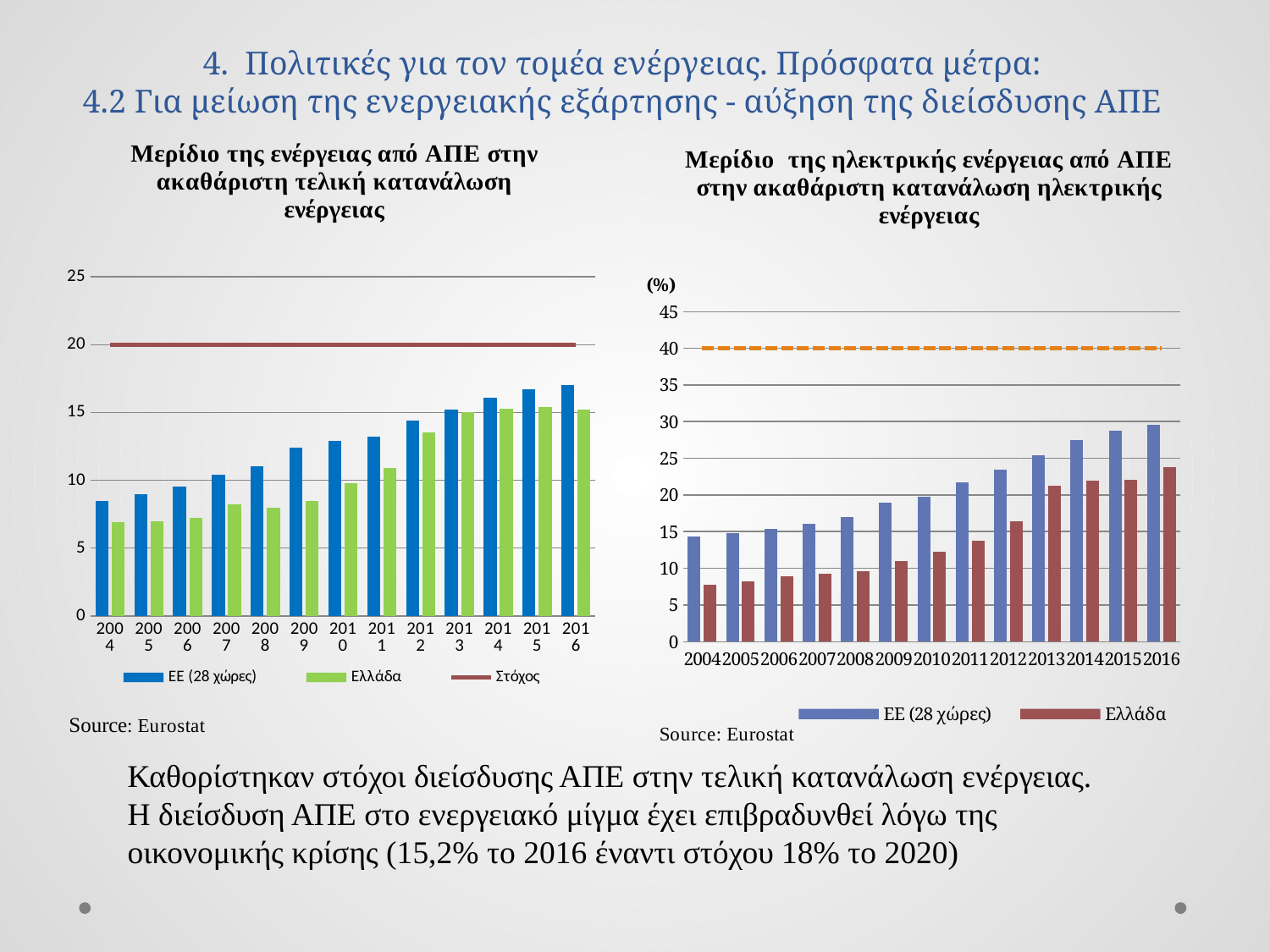
In the left chart, at what value does the Στόχος line sit? 20 What kind of chart is the left chart, 'Μερίδιο της ενέργειας από ΑΠΕ στην ακαθάριστη τελική κατανάλωση ενέργειας'? Combination bar and line chart (bars with a target line) How many years are shown on the x axis of the right chart? 13 How many series does the legend of the left chart list? 3 In the left chart, is the value for ΕΕ (28 χώρες) in 2016 greater or less than 15? greater In the right chart, is the value for ΕΕ (28 χώρες) in 2004 greater or less than 15? less In the left chart, which is larger in 2016: ΕΕ (28 χώρες) or Ελλάδα? ΕΕ (28 χώρες) In the left chart, is the value for Ελλάδα in 2004 greater or less than 10? less In the left chart, which year has the lowest value for ΕΕ (28 χώρες)? 2004 In the right chart, which year has the highest value for Ελλάδα? 2016 How many series does the legend of the right chart, 'Μερίδιο της ηλεκτρικής ενέργειας από ΑΠΕ', list? 2